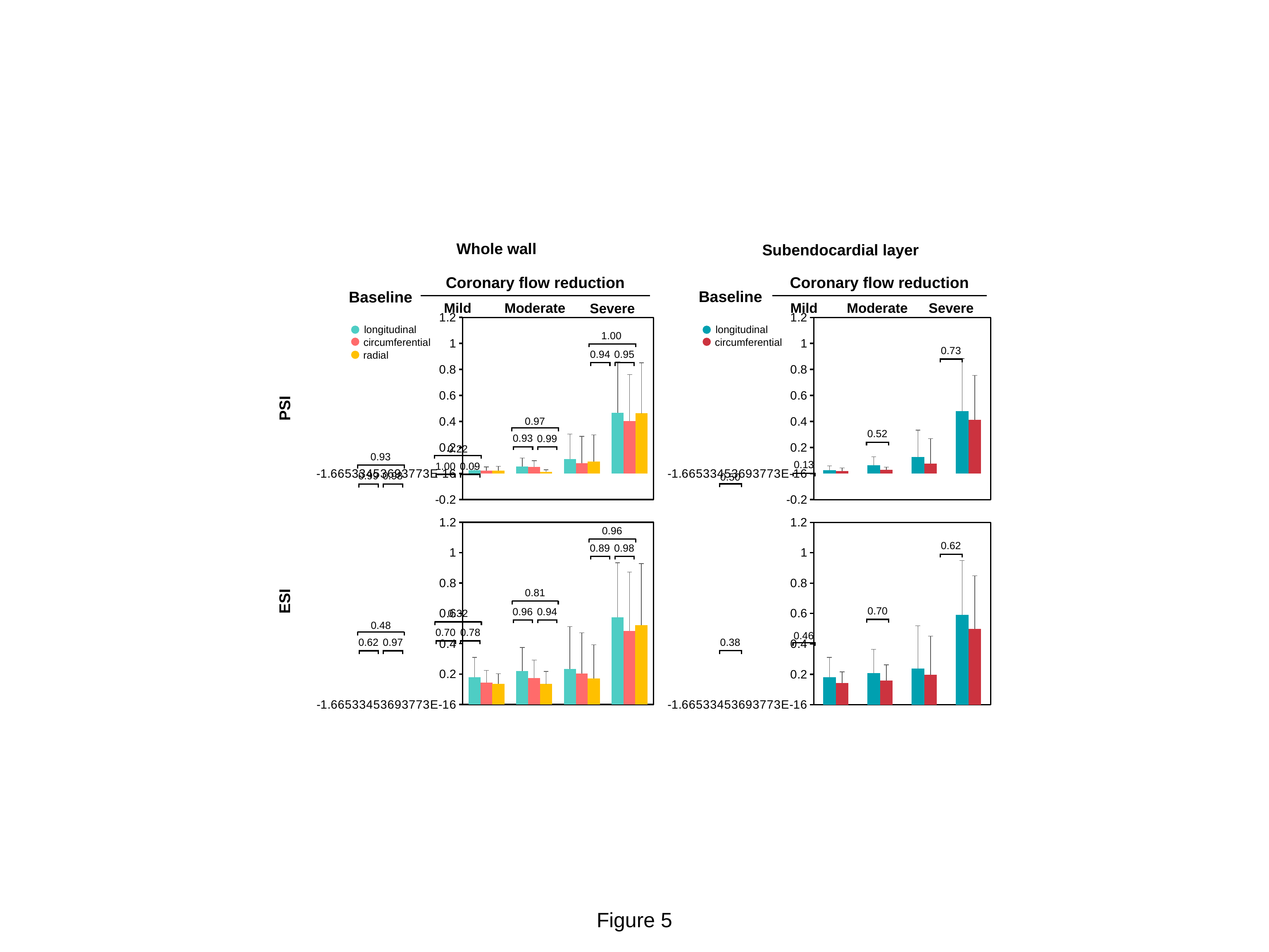
In the Subendocardial layer PSI chart (top right), which category has the shortest longitudinal bar? Baseline In the Whole wall PSI chart (top left), which category has the tallest longitudinal bar? Severe How many series does the legend of the Whole wall charts list? 3 In the Subendocardial layer ESI chart (bottom right), is the longitudinal bar for Severe greater or less than 0.4? greater In the Whole wall PSI chart (top left), what value is printed above the top bracket over the Severe group? 1.00 What kind of chart is the Whole wall PSI chart (top left)? bar chart In the Whole wall ESI chart (bottom left), do the longitudinal bars rise or fall from Baseline to Severe? rise How many series does the legend of the Subendocardial layer charts list? 2 In the Whole wall PSI chart (top left), is the longitudinal bar for Severe greater or less than 0.4? greater In the Subendocardial layer PSI chart (top right), which is larger: the longitudinal bar for Severe or the longitudinal bar for Moderate? Severe In the Whole wall PSI chart (top left), is the longitudinal bar for Mild greater or less than 0.2? less In the Whole wall PSI chart (top left), how many category groups are shown along the x axis? 4